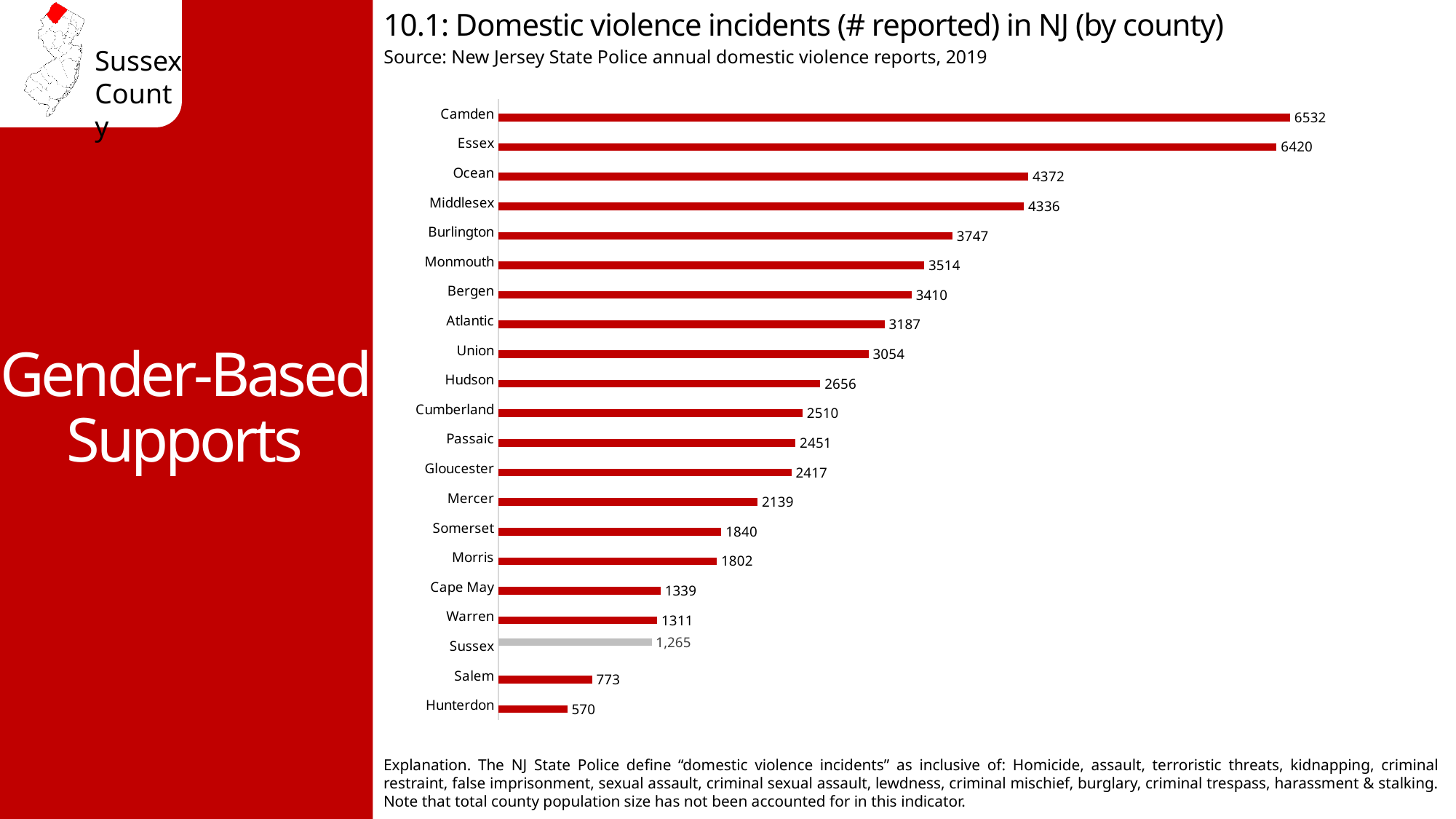
Which county reported more domestic violence incidents, Salem or Hunterdon? Salem Which county has the lowest number of reported domestic violence incidents? Hunterdon How many domestic violence incidents were reported in Sussex County? 1,265 What is the difference in reported incidents between Camden and Essex? 112 How many counties are shown in the chart? 21 How many domestic violence incidents were reported in Camden County? 6532 Which county has the highest number of reported domestic violence incidents? Camden Which county reported more domestic violence incidents, Ocean or Middlesex? Ocean What type of chart is used on this slide? Bar chart What is the difference in reported incidents between Sussex and Warren? 46 How many domestic violence incidents were reported in Morris County? 1802 Which county's bar is shown in grey rather than red? Sussex